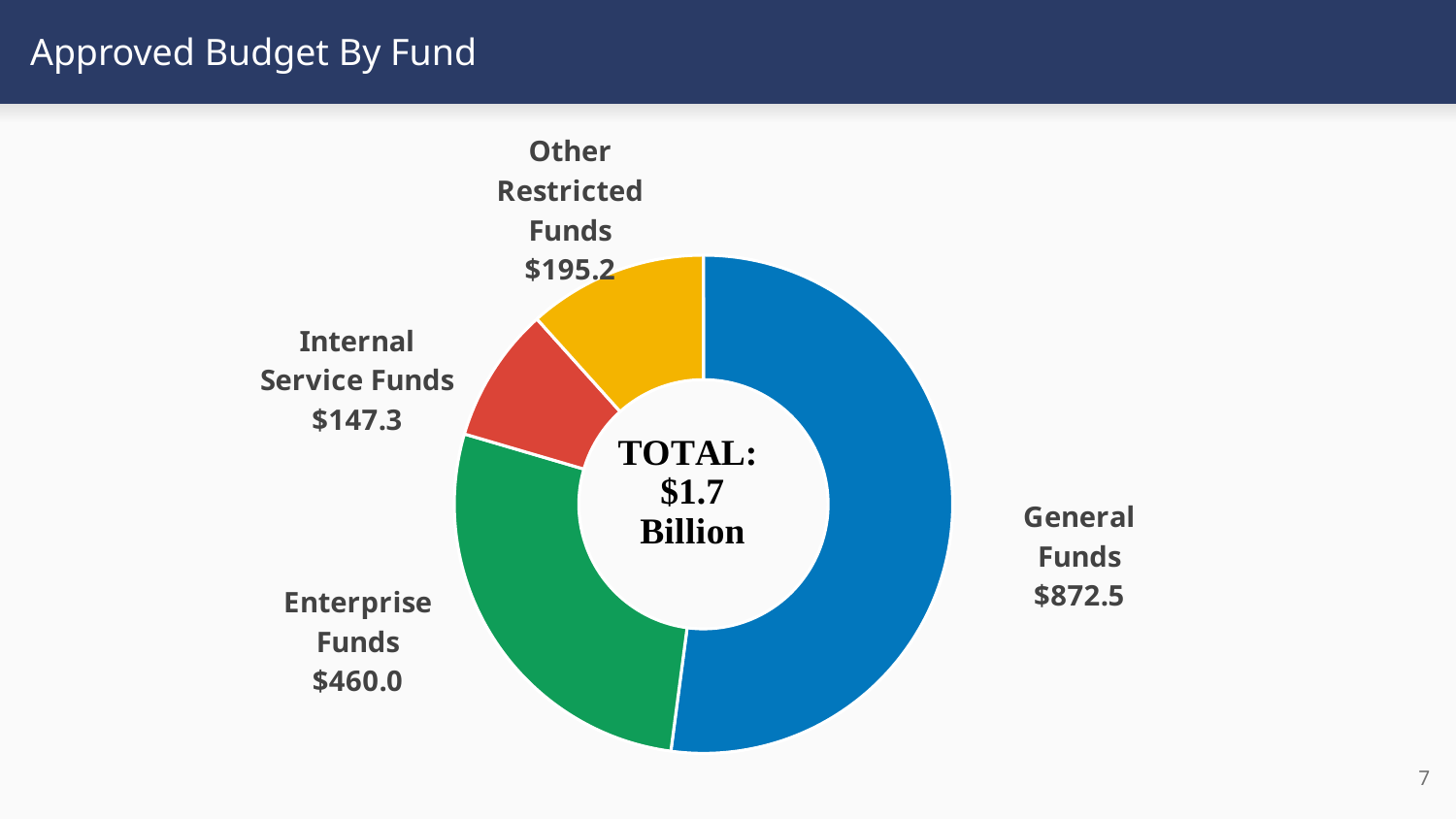
Which fund has the smallest value? Internal Service Funds What is the value for Enterprise Funds? $460.0 What is the difference between General Funds and Enterprise Funds? $412.5 What is the value for Other Restricted Funds? $195.2 Which is larger, Enterprise Funds or Other Restricted Funds? Enterprise Funds How many fund categories are shown in the chart? 4 What is the value for Internal Service Funds? $147.3 Which fund has the largest value? General Funds What total is printed in the centre of the chart? $1.7 Billion What is the difference between Other Restricted Funds and Internal Service Funds? $47.9 What is the value for General Funds? $872.5 What kind of chart is shown on the slide? Donut (pie) chart